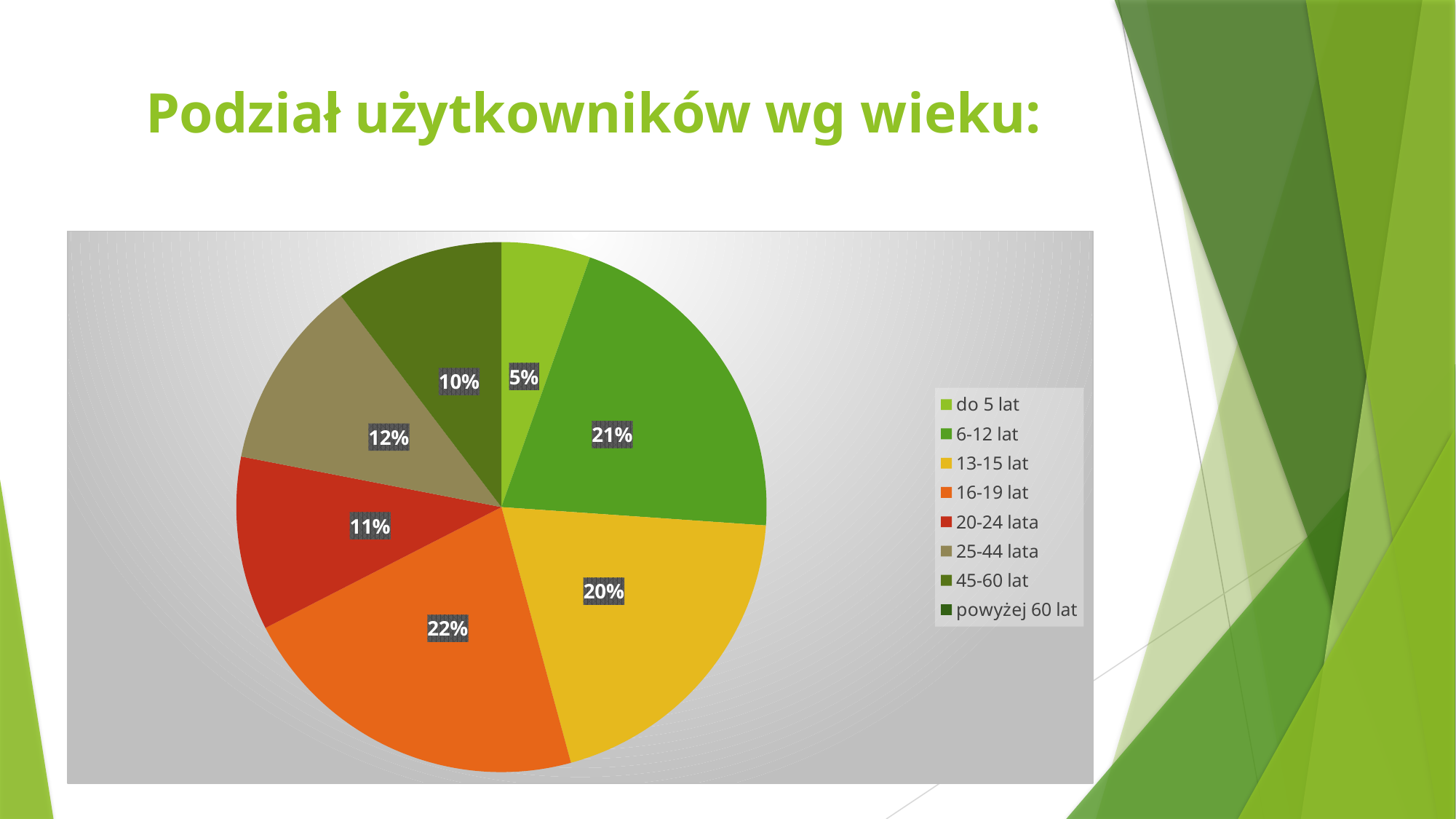
How many categories does the legend list? 8 What kind of chart is shown on the slide? pie chart Which age group has the smallest labelled share of users? do 5 lat What share of users is in the '6-12 lat' group? 21% What share of users is in the 'do 5 lat' group? 5% Which age group has the largest share of users? 16-19 lat What share of users is in the '20-24 lata' group? 11% What is the difference between the shares of the '16-19 lat' and '20-24 lata' groups? 11% What share of users is in the '25-44 lata' group? 12% What share of users is in the '13-15 lat' group? 20% What is the title of the slide? Podział użytkowników wg wieku: What share of users is in the '16-19 lat' group? 22%